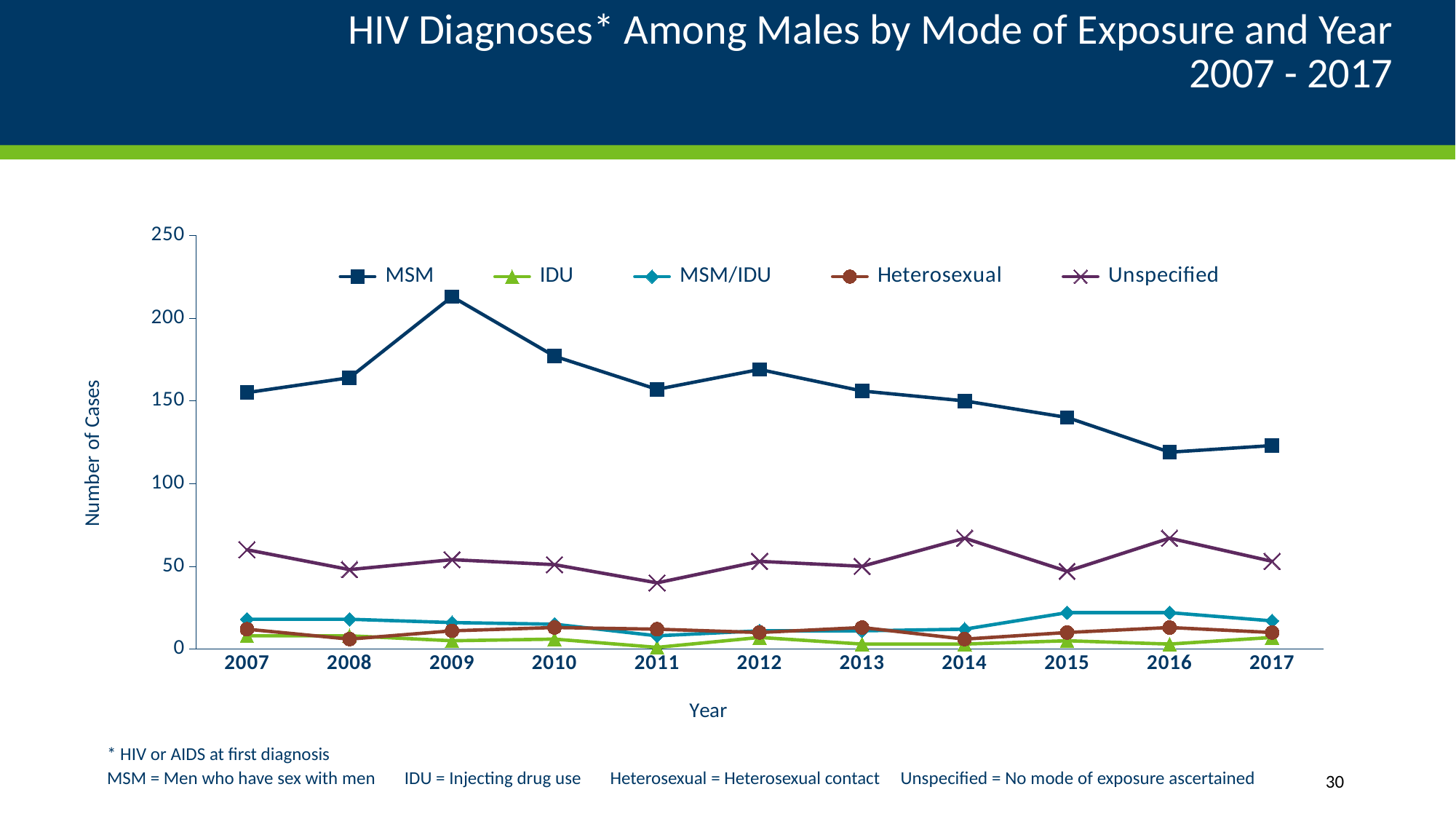
In which year does the MSM series reach its highest value? 2009 How many series does the legend list? 5 What is the title of the vertical axis? Number of Cases Is the value for Unspecified in 2011 greater or less than 50? less In 2007, which series has the larger value, Unspecified or MSM/IDU? Unspecified Does the MSM series generally rise or fall from 2009 to 2017? fall Is the value for Unspecified in 2014 greater or less than 50? greater What kind of chart is shown on the slide? line chart In 2017, which series has the larger value, MSM or Unspecified? MSM Is the value for MSM in 2009 greater or less than 200? greater How many years are plotted along the x axis? 11